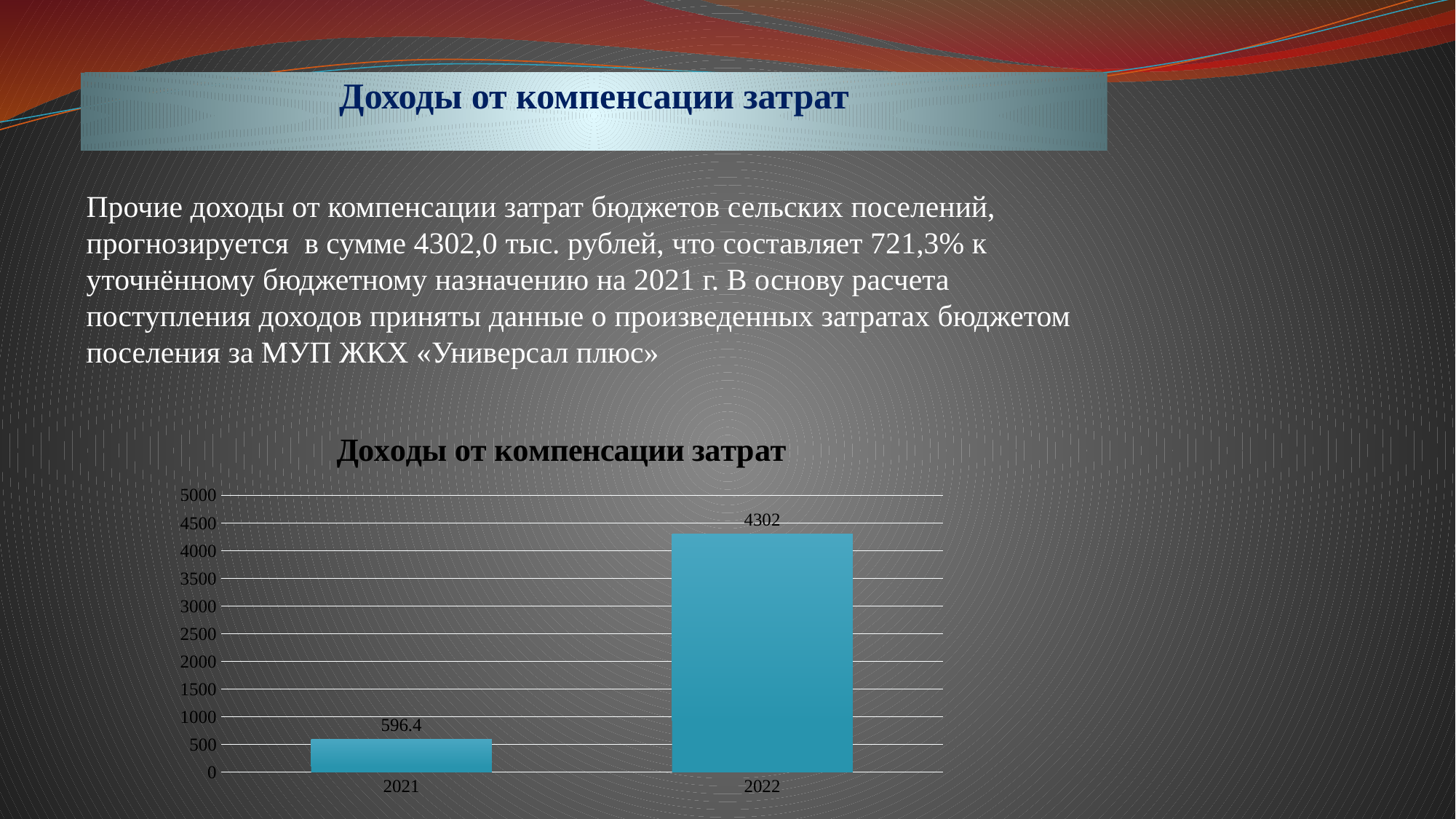
Do the values rise or fall from 2021 to 2022? rise Which is larger, the value for 2021 or the value for 2022? 2022 What is the difference between the values for 2022 and 2021? 3705.6 Which year has the highest value? 2022 Is the value for 2021 greater or less than 1000? less How many categories are shown on the x axis? 2 What is the title of the chart? Доходы от компенсации затрат What is the value for 2022? 4302 Which year has the lowest value? 2021 What is the value for 2021? 596.4 Is the value for 2022 greater or less than 4000? greater What kind of chart is shown? bar chart